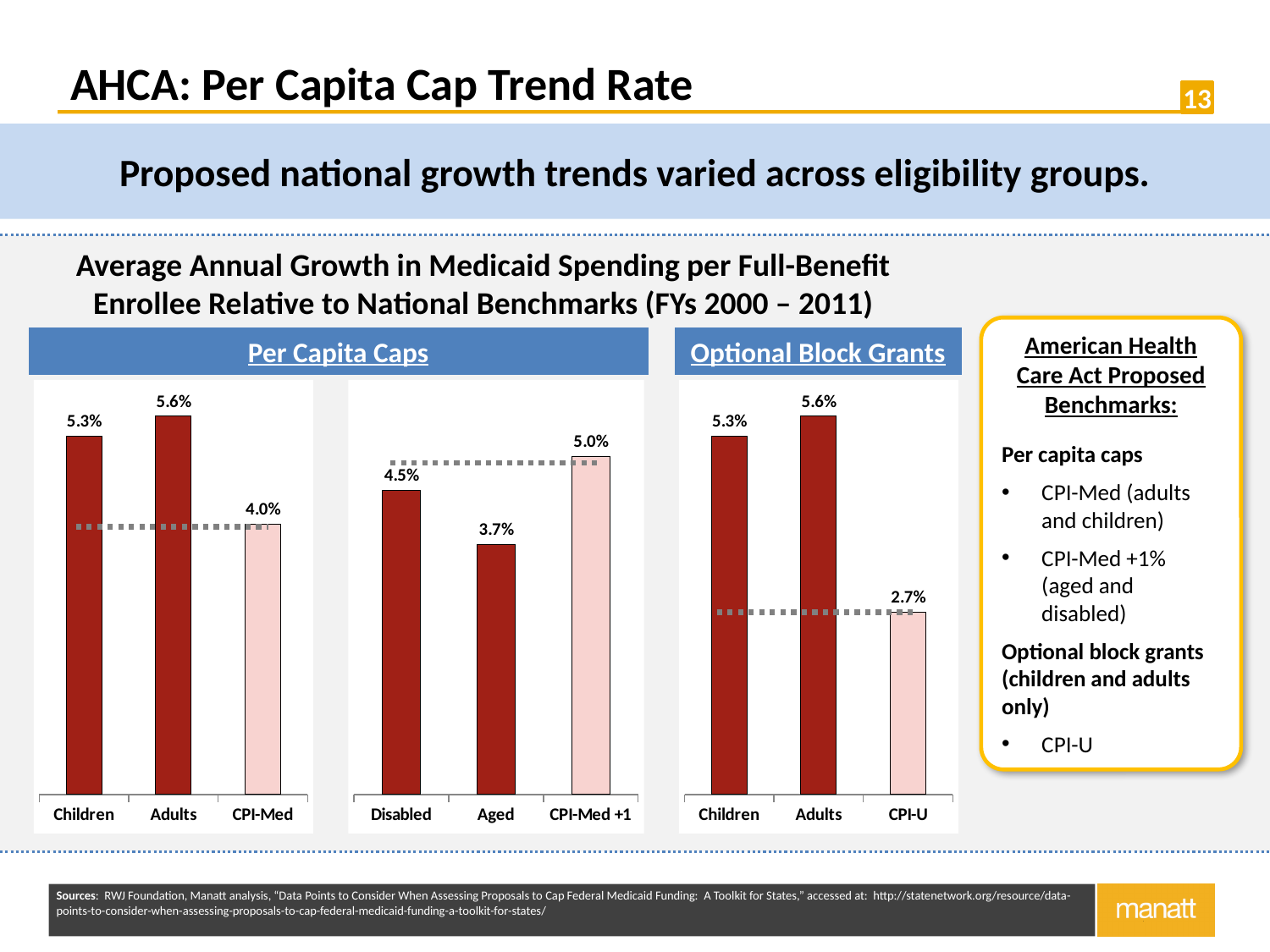
In the left chart (Per Capita Caps), which is larger, the value for Children or the value for CPI-Med? Children In the middle chart (Disabled/Aged/CPI-Med +1), which category has the highest value? CPI-Med +1 How many categories are shown in the Optional Block Grants chart? 3 In the middle chart (Disabled/Aged/CPI-Med +1), what is the value for Aged? 3.7% What type of chart is the Per Capita Caps chart? Bar chart In the Optional Block Grants chart, what is the difference between the Adults value and the CPI-U value? 2.9% In the middle chart (Disabled/Aged/CPI-Med +1), what is the value for CPI-Med +1? 5.0% In the Optional Block Grants chart, what is the value for CPI-U? 2.7% In the Optional Block Grants chart, which category has the lowest value? CPI-U In the left chart (Per Capita Caps, Children/Adults/CPI-Med), what is the value for Adults? 5.6% In the left chart (Per Capita Caps), what is the value for CPI-Med? 4.0% In the middle chart (Disabled/Aged/CPI-Med +1), what is the difference between the Disabled and Aged values? 0.8%